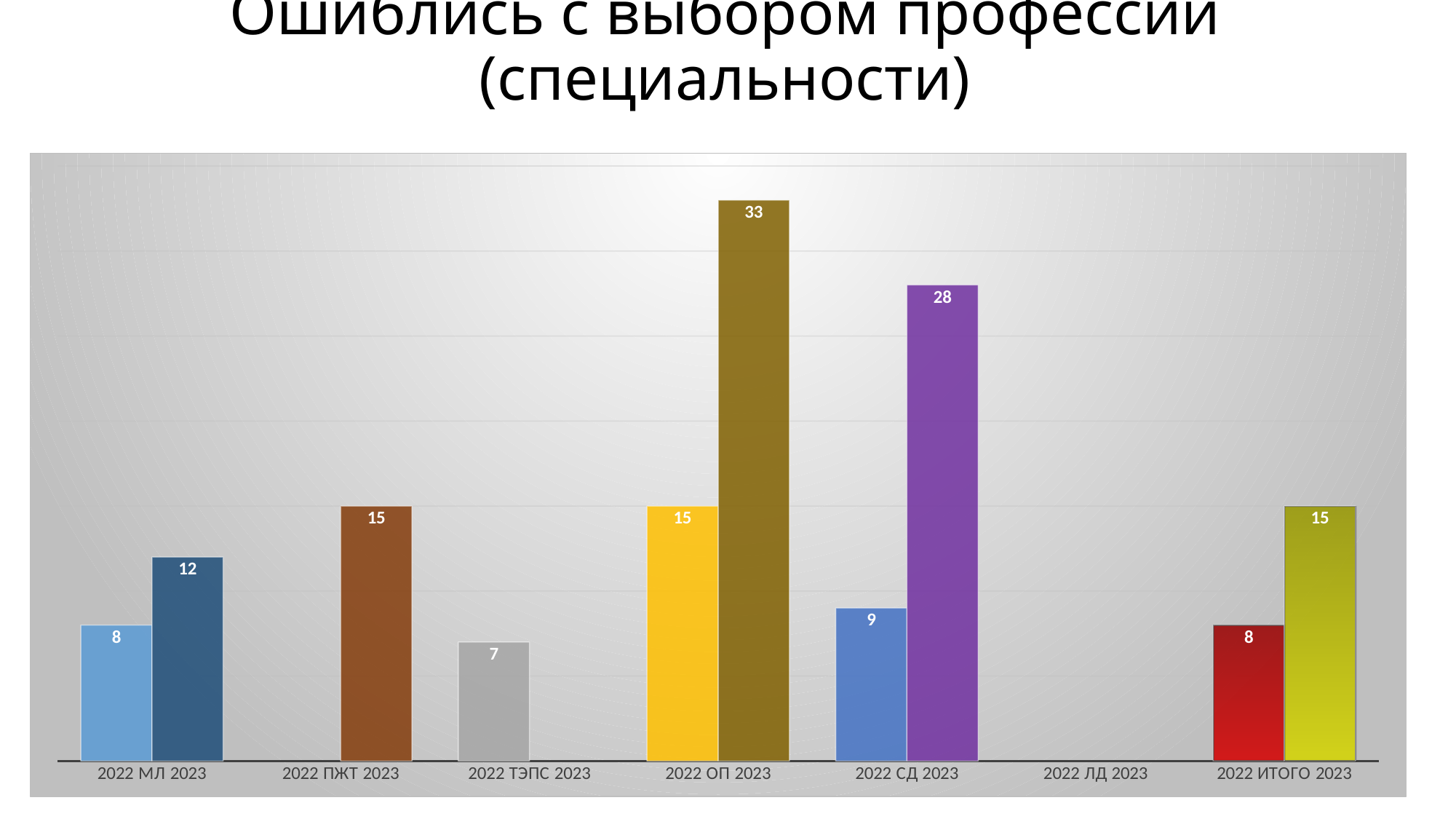
What is the title of the chart? Ошиблись с выбором профессии (специальности) What is the difference between the 2023 and 2022 bars for ОП? 18 What is the value of the 2023 bar for ИТОГО? 15 What is the value of the 2022 bar for МЛ? 8 What is the value of the 2023 bar for ОП? 33 Which bar has the highest value on the chart? ОП 2023 (33) What is the value of the single bar shown for ТЭПС? 7 What is the difference between the 2023 and 2022 bars for СД? 19 Which bar has the lowest value on the chart? ТЭПС (7) How many category groups are labelled on the x axis? 7 What kind of chart is shown on the slide? Bar chart